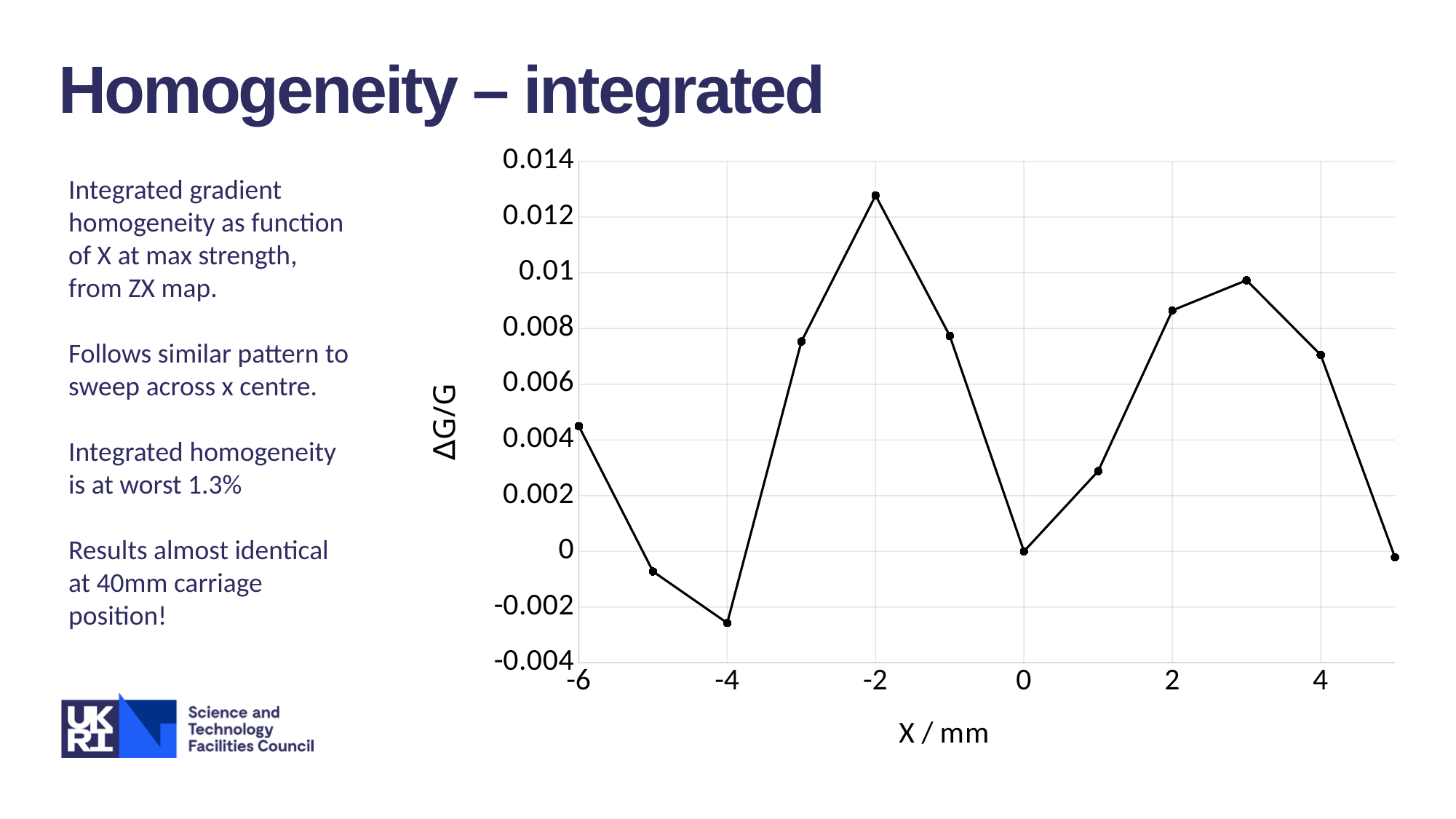
Is the value of ΔG/G at X = -4 greater or less than -0.002? less What kind of chart is shown on the slide? line chart Is the value of ΔG/G at X = 2 greater or less than 0.008? greater How many data points are plotted on the chart? 12 Which has the larger ΔG/G value, X = -6 or X = 1? X = -6 Does ΔG/G rise or fall as X goes from -4 to -2? rise What is the label of the x axis? X / mm Is the value of ΔG/G at X = -2 greater or less than 0.012? greater At which X value does the chart reach its lowest ΔG/G? -4 At which X value does the chart reach its highest ΔG/G? -2 Which has the larger ΔG/G value, X = -2 or X = 3? X = -2